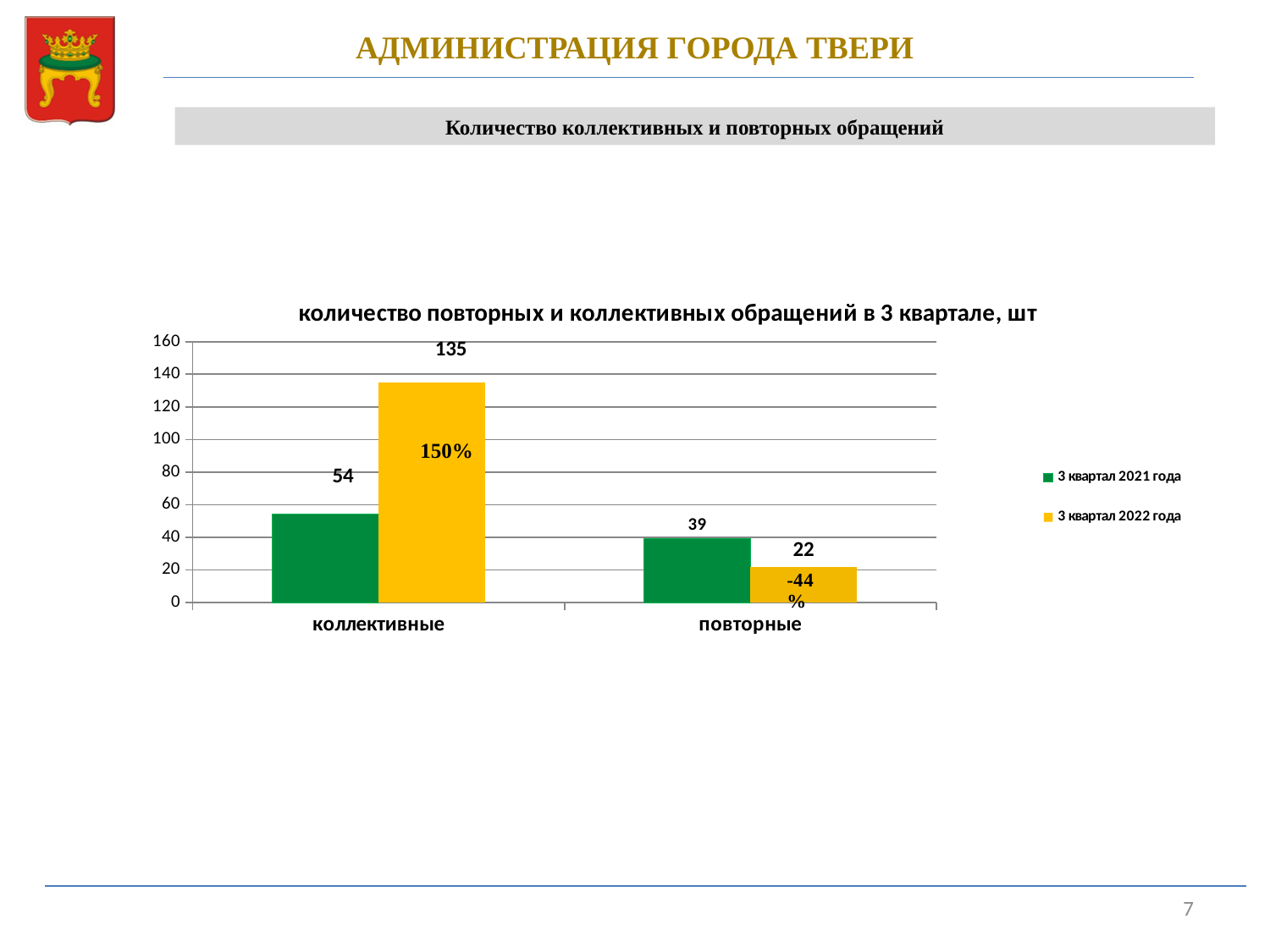
What is the value for повторные in 3 квартал 2021 года? 39 How many series does the legend list? 2 What percentage change is labelled on the коллективные bar for 3 квартал 2022 года? 150% What is the value for коллективные in 3 квартал 2021 года? 54 How many categories are shown on the x axis? 2 What is the difference between the 3 квартал 2022 года and 3 квартал 2021 года values for коллективные? 81 What is the value for коллективные in 3 квартал 2022 года? 135 Which is larger for повторные: 3 квартал 2021 года or 3 квартал 2022 года? 3 квартал 2021 года Which bar has the highest value on the chart? коллективные, 3 квартал 2022 года What is the value for повторные in 3 квартал 2022 года? 22 What kind of chart is shown on the slide? bar chart Which bar has the lowest value on the chart? повторные, 3 квартал 2022 года